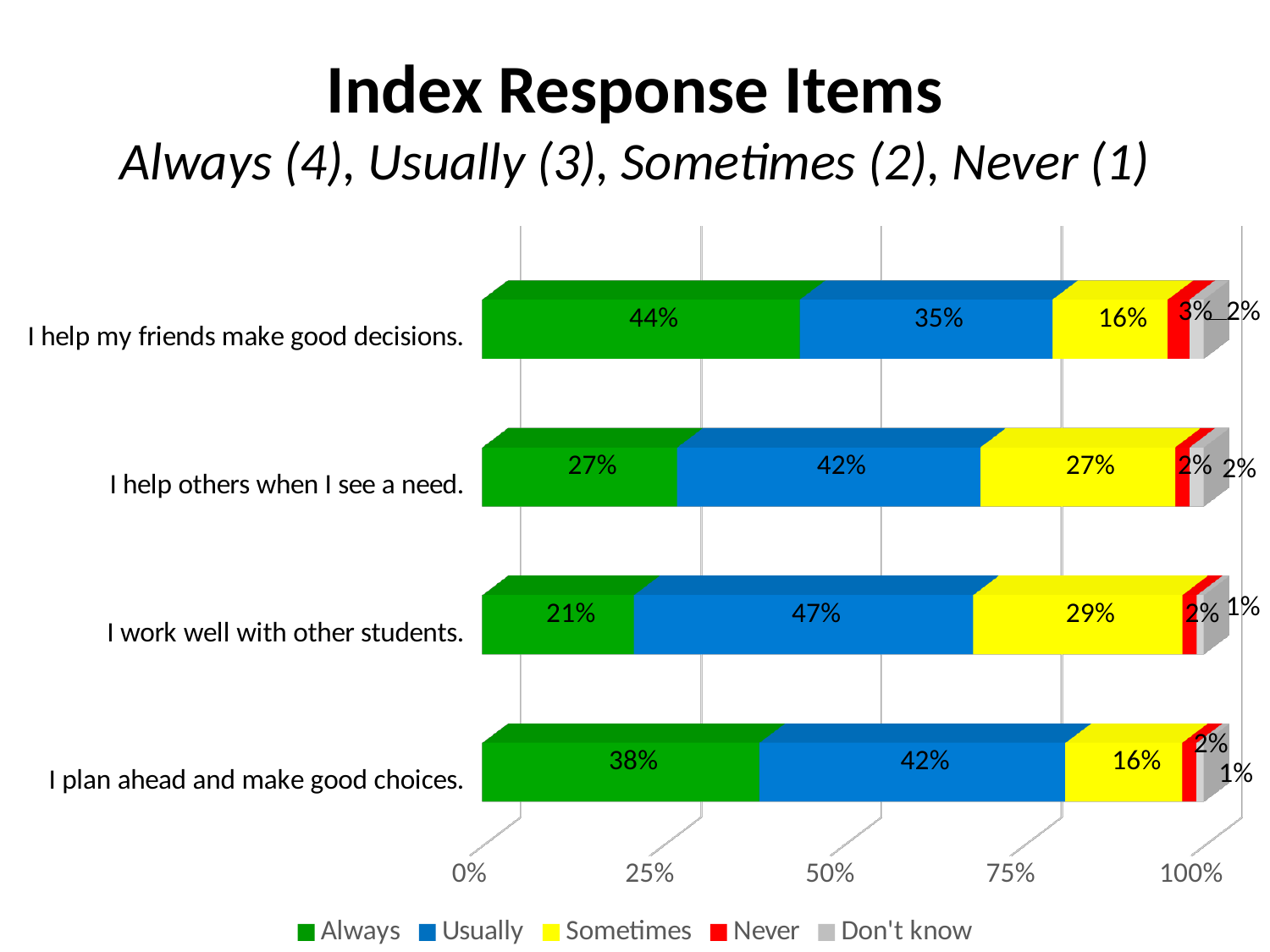
What is the "Sometimes" value for "I plan ahead and make good choices."? 16% What is the difference between the "Always" values for "I help my friends make good decisions." and "I plan ahead and make good choices."? 6% Which item has the lowest "Always" percentage? I work well with other students. Which is larger: the "Sometimes" value for "I work well with other students." or for "I help others when I see a need."? I work well with other students. What is the "Usually" value for "I work well with other students."? 47% How many series does the legend list? 5 Which item has the highest "Always" percentage? I help my friends make good decisions. What is the total of the stacked bar for "I help my friends make good decisions."? 100% How many items (categories) are shown on the chart? 4 What kind of chart is shown on the slide? Stacked bar chart What is the "Never" value for "I help others when I see a need."? 2% What percentage of respondents answered "Always" for "I help my friends make good decisions."? 44%